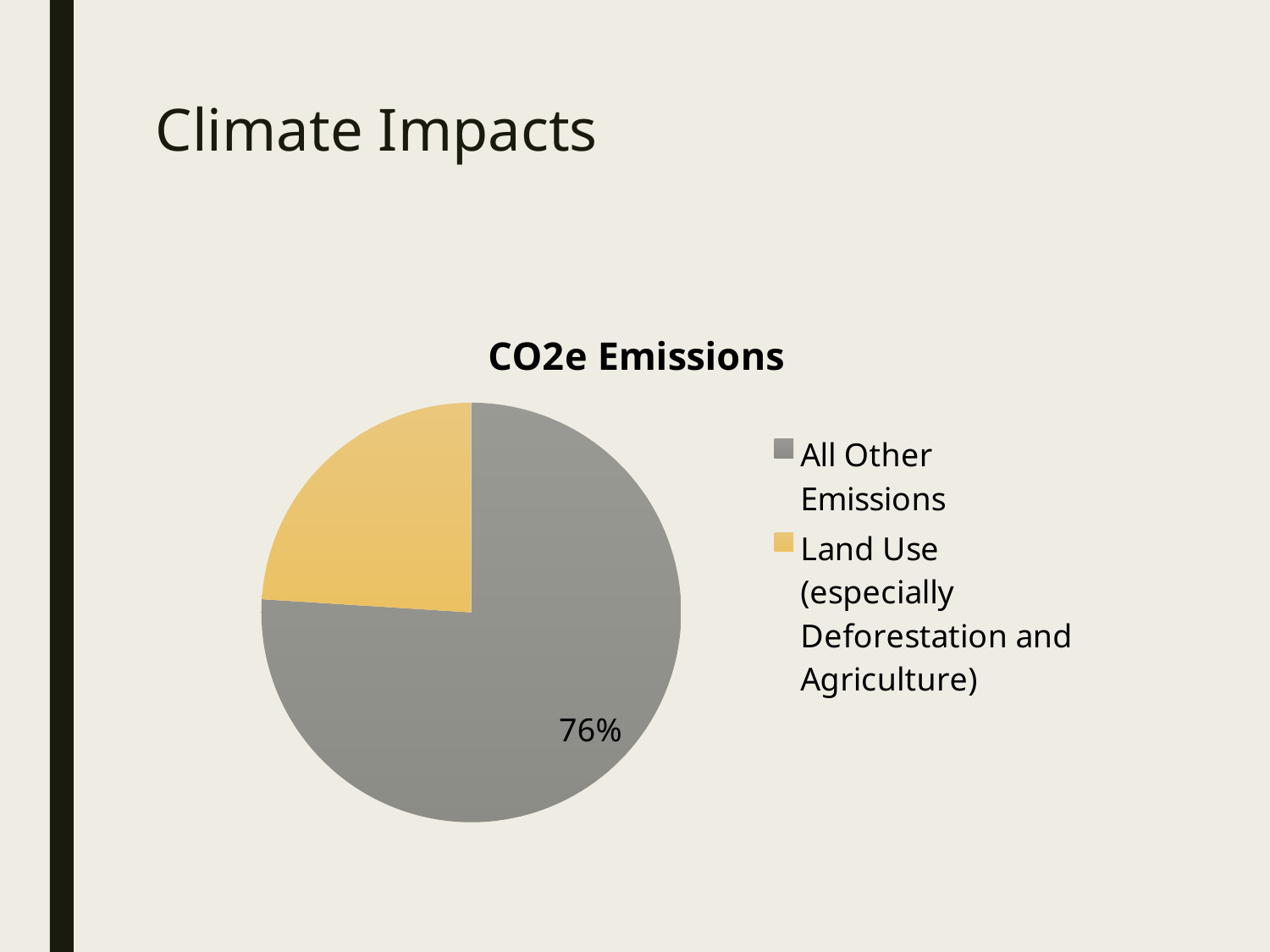
What kind of chart is shown on the slide? pie chart Which slice of the pie is the smallest? Land Use (especially Deforestation and Agriculture) What is the value printed on the All Other Emissions slice? 76% Which is larger, the All Other Emissions slice or the Land Use slice? All Other Emissions How many slices does the pie chart have? 2 Which slice of the pie is the largest? All Other Emissions How many entries does the legend list? 2 What colour is the Land Use (especially Deforestation and Agriculture) slice? yellow What share of the pie does All Other Emissions take? 76% What is the title of the chart? CO2e Emissions